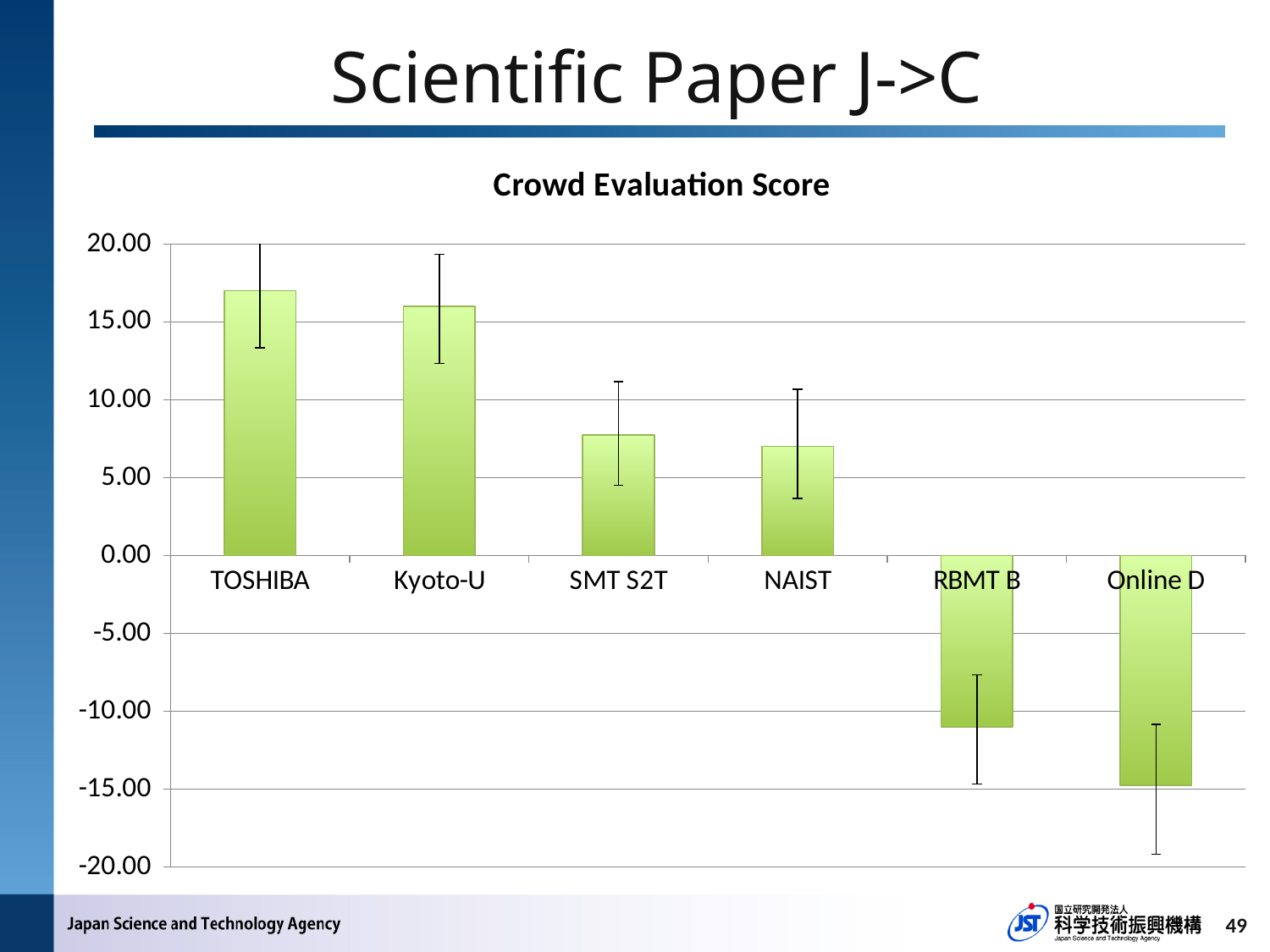
What kind of chart is shown on the slide? bar chart Which has the larger Crowd Evaluation Score, TOSHIBA or SMT S2T? TOSHIBA Which category has the lowest Crowd Evaluation Score? Online D How many categories have a negative Crowd Evaluation Score? 2 Is the value for Online D greater or less than -10.00? less Is the value for TOSHIBA greater or less than 15.00? greater Is the value for SMT S2T greater or less than 10.00? less How many categories are plotted on the x axis of the Crowd Evaluation Score chart? 6 Do the values generally rise or fall moving from left to right along the x axis? fall What is the title of the chart? Crowd Evaluation Score